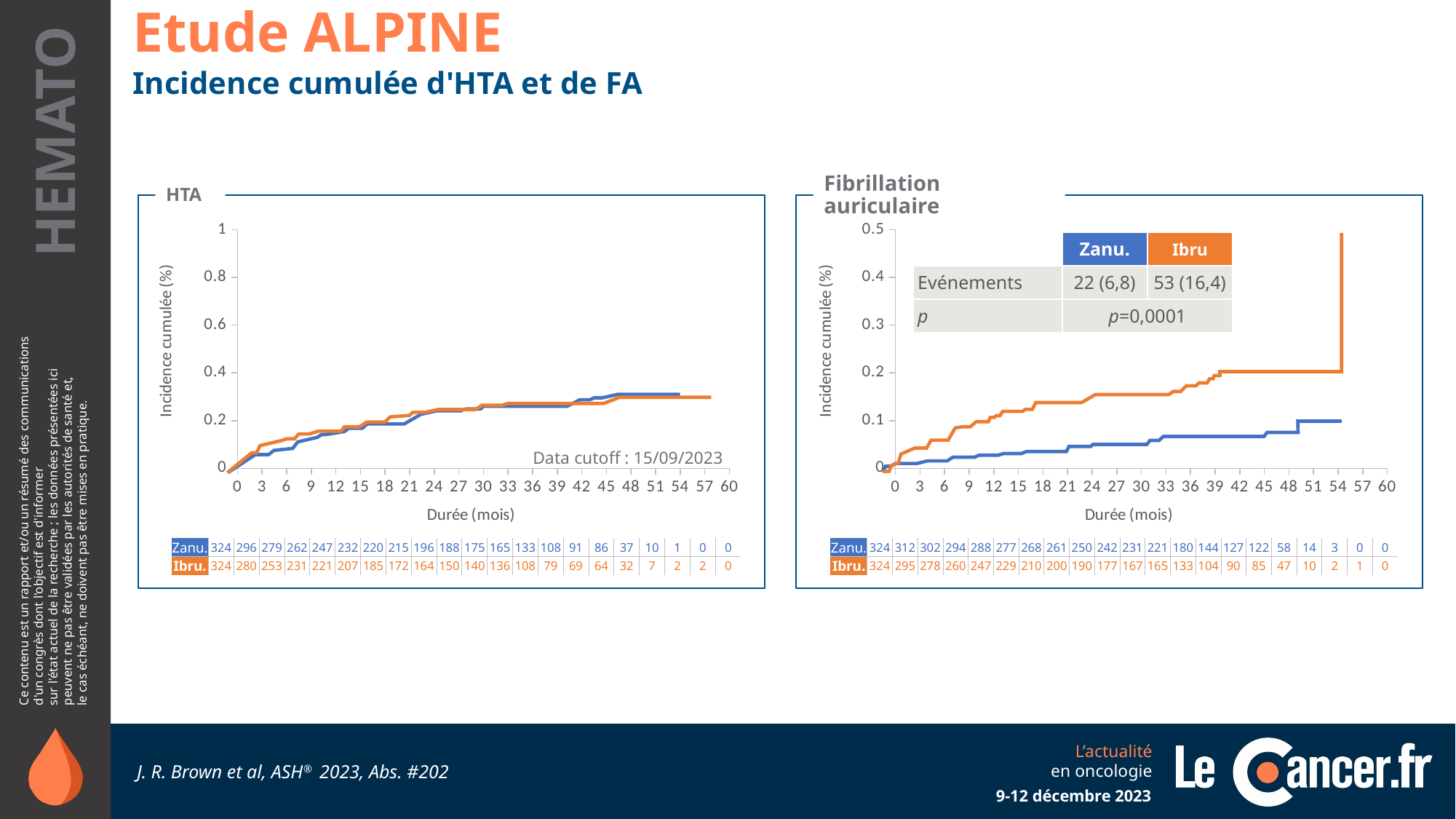
In the Fibrillation auriculaire chart, is the value for Zanu. at 24 months greater or less than 0.1? less What kind of chart is the HTA chart on the left? line chart In the Fibrillation auriculaire chart, which series is higher at 30 months, Zanu. or Ibru? Ibru In the HTA chart, is the value for Zanu. at 48 months greater or less than 0.2? greater In the Fibrillation auriculaire chart, how many events are reported for Ibru? 53 (16,4) In the HTA chart, how many Ibru patients are at risk at 24 months according to the table below the chart? 164 In the Fibrillation auriculaire chart, is the value for Ibru at 24 months greater or less than 0.1? greater What is the y-axis label of the HTA chart? Incidence cumulée (%) In the Fibrillation auriculaire chart, what p-value is shown? p=0,0001 In the HTA chart, do the cumulative incidence curves rise or fall along the x axis? rise How many series are plotted in the Fibrillation auriculaire chart? 2 In the Fibrillation auriculaire chart, how many events are reported for Zanu.? 22 (6,8)